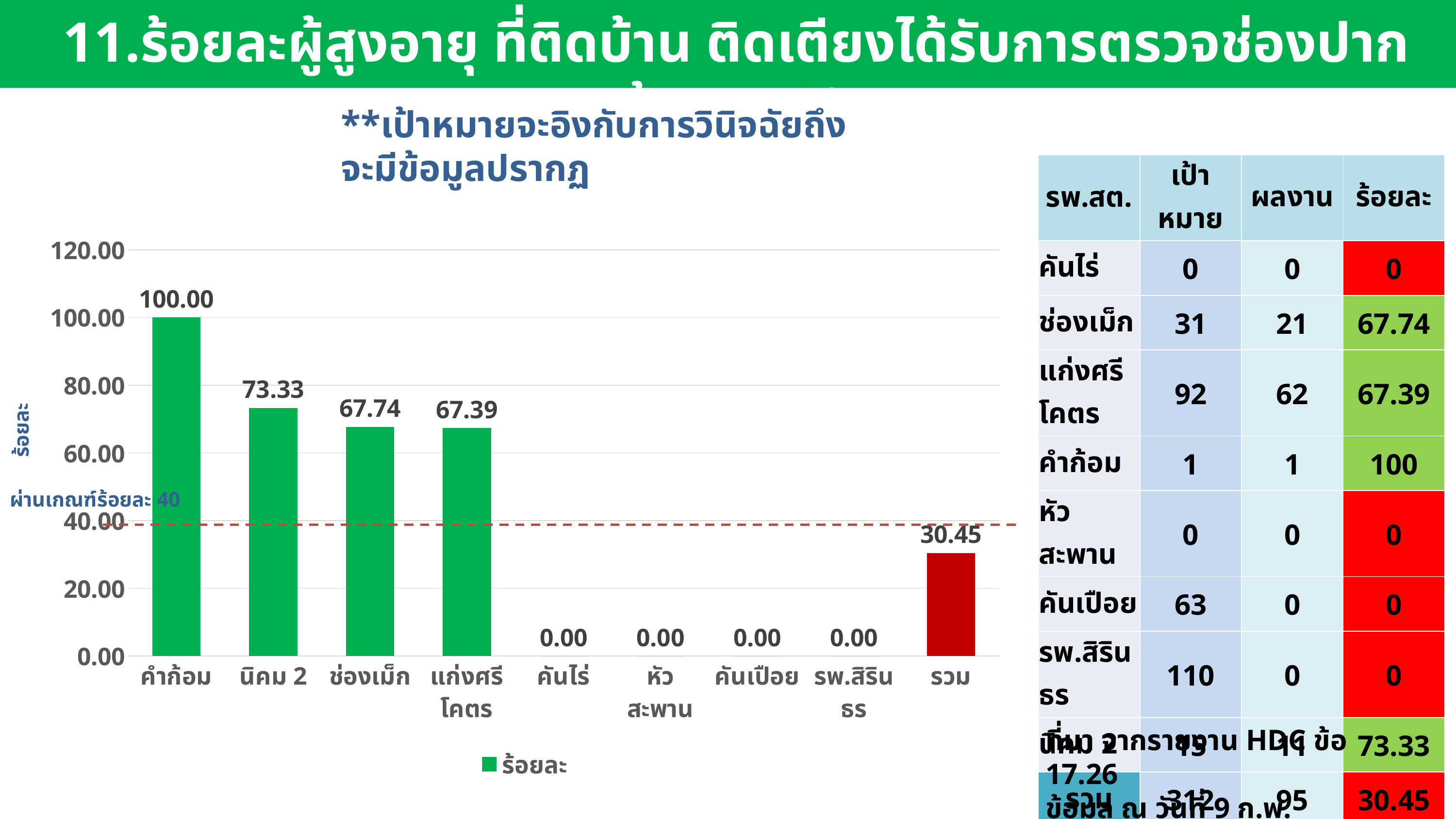
What is the value for รวม? 30.45 What is the legend entry for the series? ร้อยละ Which is larger, the value for ช่องเม็ก or the value for แก่งศรีโคตร? ช่องเม็ก What is the value for แก่งศรีโคตร? 67.39 What is the value for นิคม 2? 73.33 Is the value for รวม greater or less than 40? less What is the difference between the values for นิคม 2 and ช่องเม็ก? 5.59 How many categories are shown on the x axis? 9 What kind of chart is shown? bar chart What is the value for คำก้อม? 100.00 Which category has the highest value? คำก้อม How many series does the legend list? 1